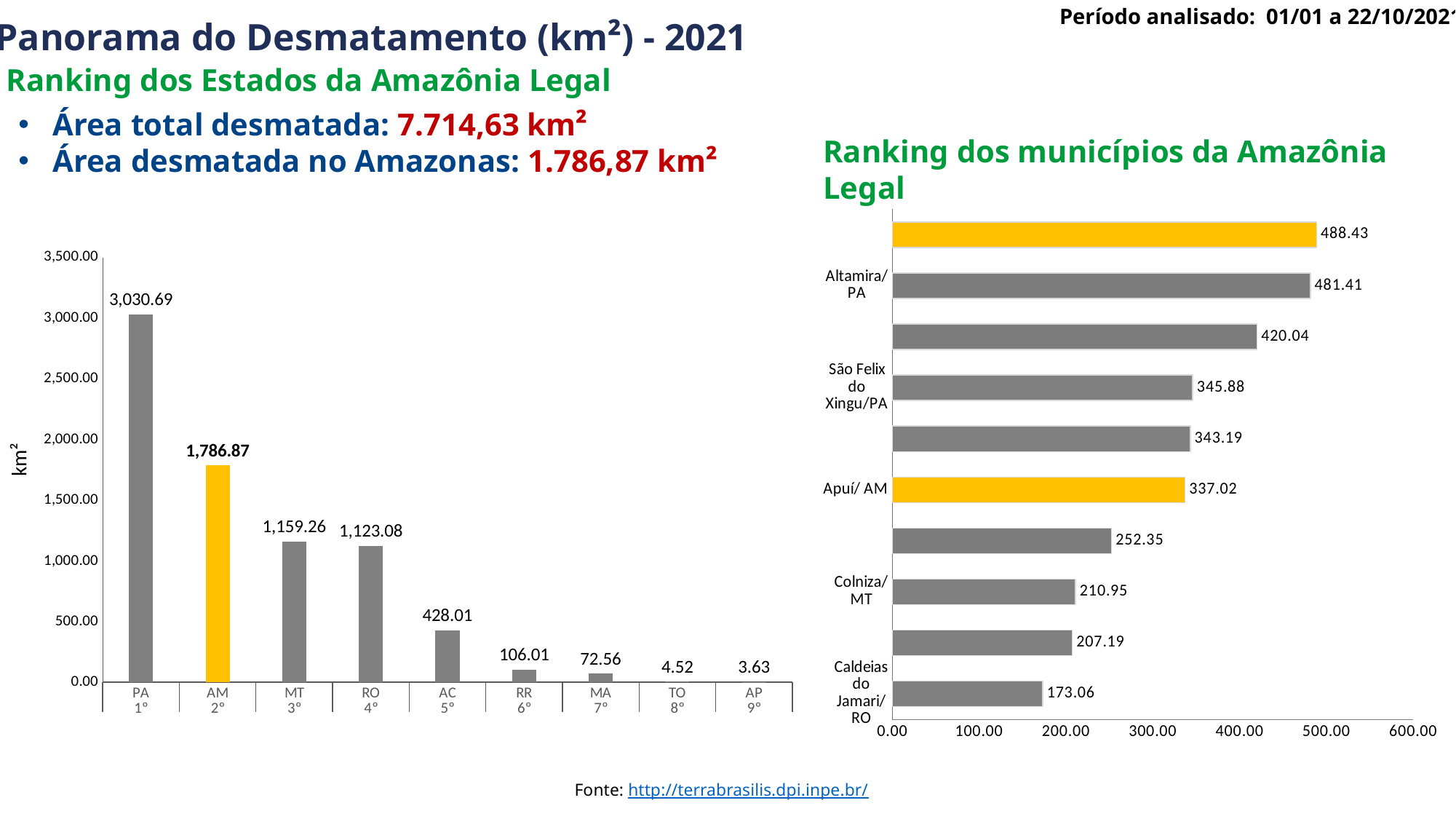
In the 'Ranking dos Estados da Amazônia Legal' chart, what is the value for PA? 3,030.69 In the 'Ranking dos Estados da Amazônia Legal' chart, how many states are shown? 9 In the 'Ranking dos municípios da Amazônia Legal' chart, what is the value for Apuí/AM? 337.02 In the 'Ranking dos municípios da Amazônia Legal' chart, what is the value for Altamira/PA? 481.41 In the 'Ranking dos Estados da Amazônia Legal' chart, what is the difference between the values for MT and RO? 36.18 In the 'Ranking dos municípios da Amazônia Legal' chart, what is the difference between the values for São Felix do Xingu/PA and Apuí/AM? 8.86 What kind of chart is the 'Ranking dos Estados da Amazônia Legal' chart? Bar chart In the 'Ranking dos Estados da Amazônia Legal' chart, do the values rise or fall from left to right? Fall In the 'Ranking dos municípios da Amazônia Legal' chart, which is larger, the value for Colniza/MT or the value for Caldeias do Jamari/RO? Colniza/MT In the 'Ranking dos Estados da Amazônia Legal' chart, which state has the highest value? PA In the 'Ranking dos Estados da Amazônia Legal' chart, what is the value for AM? 1,786.87 In the 'Ranking dos Estados da Amazônia Legal' chart, which state has the lowest value? AP